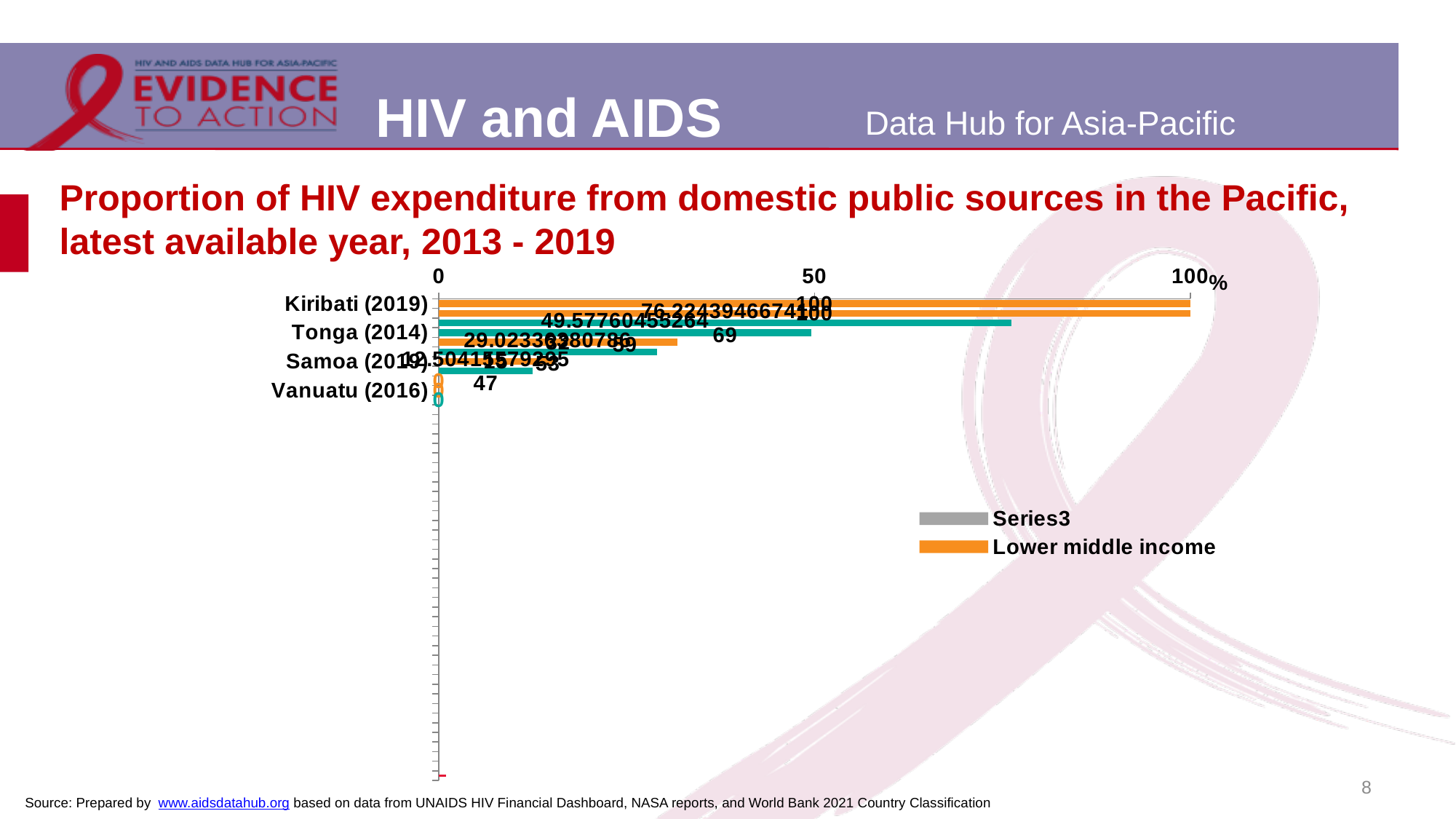
What is the value of the Lower middle income bar for Kiribati (2019)? 100 What is the maximum value shown on the horizontal axis of the chart? 100 Is the value for Kiribati (2019) greater or less than 50? greater How many series does the chart legend list? 2 Which country has a larger proportion of HIV expenditure from domestic public sources, Kiribati (2019) or Vanuatu (2016)? Kiribati (2019) Is the value for Vanuatu (2016) greater or less than 50? less What kind of chart is shown on the slide? Bar chart What is the name of the second series listed in the chart legend? Lower middle income How many countries are listed on the vertical axis of the chart? 4